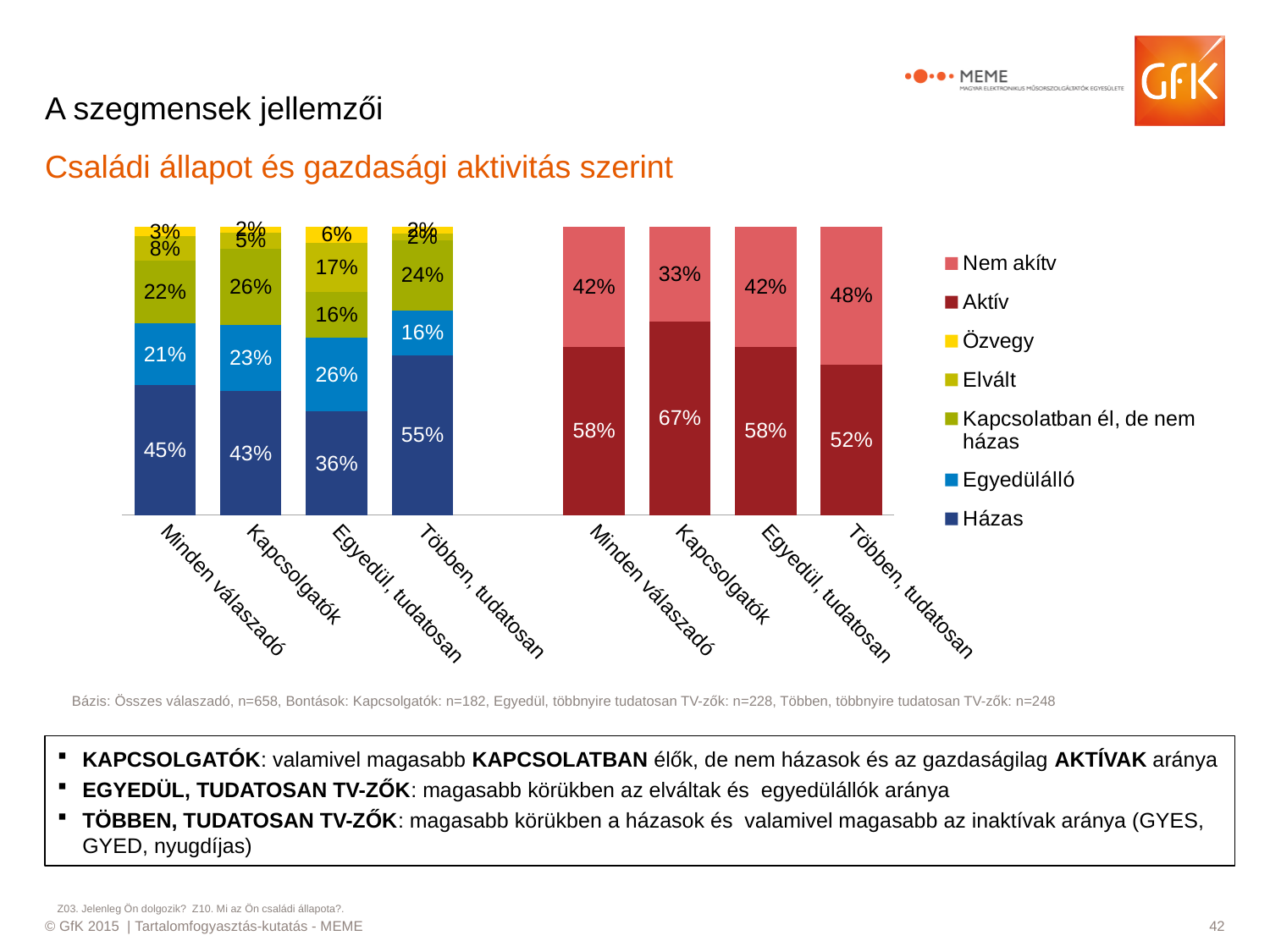
Which group has the lowest Házas share? Egyedül, tudatosan What is the combined share of Aktív and Nem akítv for Többen, tudatosan? 100% How many entries does the legend list? 7 Which group has the highest Aktív share? Kapcsolgatók Which is larger: the Elvált share for Egyedül, tudatosan or for Minden válaszadó? Egyedül, tudatosan Which colour represents Házas in the legend? Dark blue What is the difference between the Nem akítv share of Többen, tudatosan and that of Kapcsolgatók? 15 percentage points What is the Nem akítv share for Minden válaszadó? 42% What share of Kapcsolgatók are Aktív (economically active)? 67% What is the Egyedülálló share for Egyedül, tudatosan? 26% What is the Házas (married) share among Többen, tudatosan? 55% What type of chart is shown on the slide? Stacked bar chart